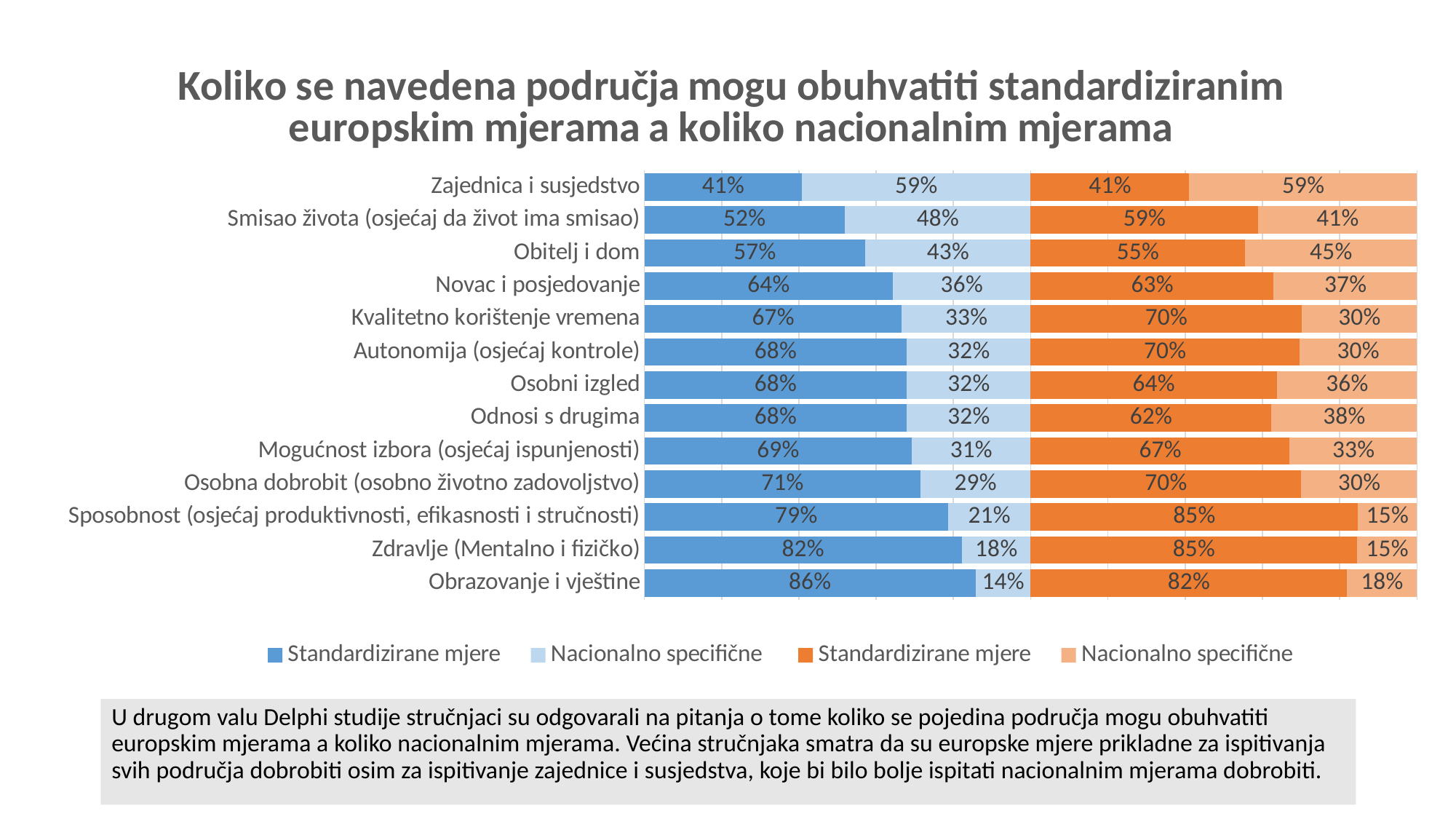
Which category has the highest dark blue (first 'Standardizirane mjere') value? Obrazovanje i vještine What is the light orange (second 'Nacionalno specifične') value for 'Novac i posjedovanje'? 37% How many categories (areas) are listed on the vertical axis of the chart? 13 What is the total of the dark blue and light blue segments for 'Zajednica i susjedstvo'? 100% What is the dark orange (second 'Standardizirane mjere') value for 'Zdravlje (Mentalno i fizičko)'? 85% How many series does the chart legend list? 4 Which category has the lowest dark orange (second 'Standardizirane mjere') value? Zajednica i susjedstvo What kind of chart is shown on the slide? Stacked bar chart Which category has the lowest dark blue (first 'Standardizirane mjere') value? Zajednica i susjedstvo For 'Obrazovanje i vještine', what is the difference between the dark blue value (86%) and the dark orange value (82%)? 4 percentage points What is the dark blue (first 'Standardizirane mjere') value for 'Obrazovanje i vještine'? 86% For 'Smisao života (osjećaj da život ima smisao)', which is larger: the dark blue value or the dark orange value? The dark orange value (59%)